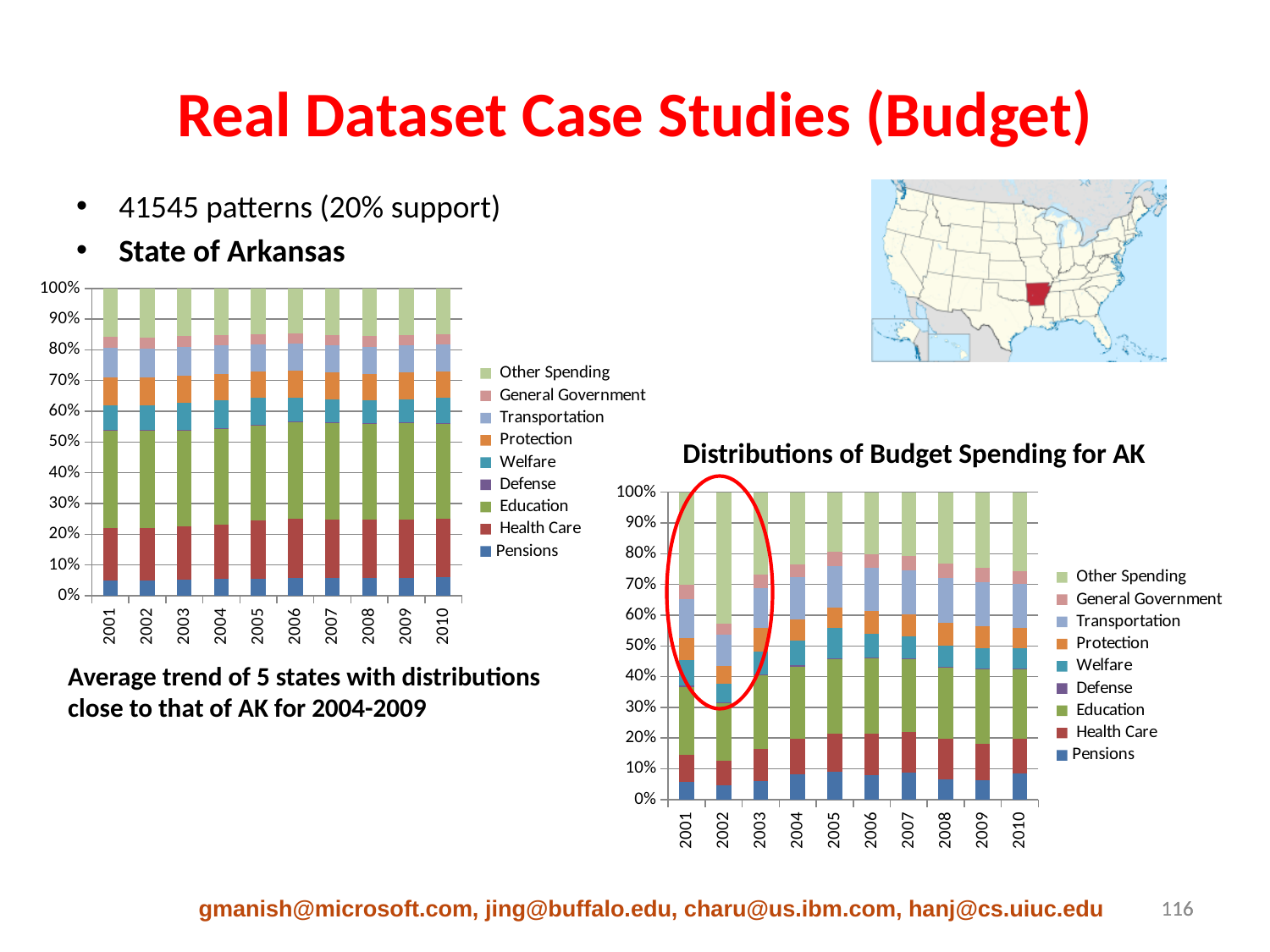
How many years are shown on the x axis of the 'Distributions of Budget Spending for AK' chart? 10 What kind of chart is the 'Distributions of Budget Spending for AK' chart? Stacked bar chart Which series is listed at the bottom of the legend in the 'Distributions of Budget Spending for AK' chart? Pensions In the left chart (average trend of 5 states), is the Education share in 2001 greater or less than 20%? greater How many series does the legend of the left chart (average trend of 5 states) list? 9 What is the total of each stacked bar in the 'Distributions of Budget Spending for AK' chart? 100% What is the title of the chart on the right of the slide? Distributions of Budget Spending for AK How many series does the legend of the 'Distributions of Budget Spending for AK' chart list? 9 In the 'Distributions of Budget Spending for AK' chart, is the Other Spending share larger in 2002 or in 2005? 2002 What is the first year on the x axis of the left chart (average trend of 5 states)? 2001 In the 'Distributions of Budget Spending for AK' chart, is the Other Spending share in 2002 greater or less than 30%? greater